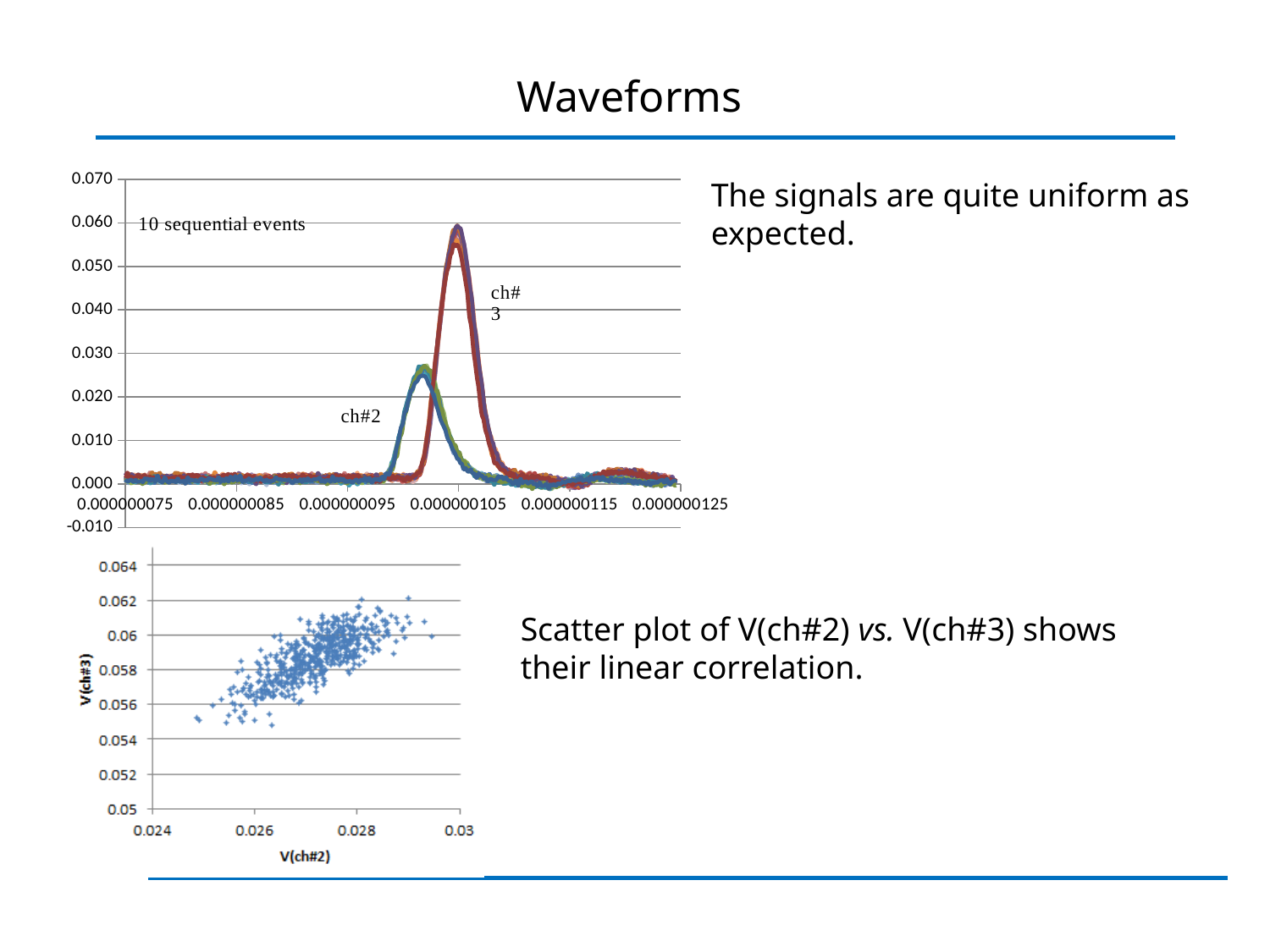
In the top chart, is the peak value of ch#2 greater or less than 0.030? less In the bottom chart, is the lowest plotted V(ch#3) value greater or less than 0.054? greater In the bottom chart, what is the label of the x axis? V(ch#2) In the top chart, which channel's peak occurs earlier along the x axis, ch#2 or ch#3? ch#2 In the top chart, which channel has the higher peak, ch#2 or ch#3? ch#3 In the top chart, what is the highest value shown on the y axis? 0.070 In the top chart, is the peak value of ch#2 greater or less than 0.020? greater In the top chart, how many sequential events does the annotation say are plotted? 10 In the bottom chart, does V(ch#3) rise or fall as V(ch#2) increases? rise What kind of chart is the top chart on the slide? line chart What kind of chart is the bottom chart on the slide? scatter plot